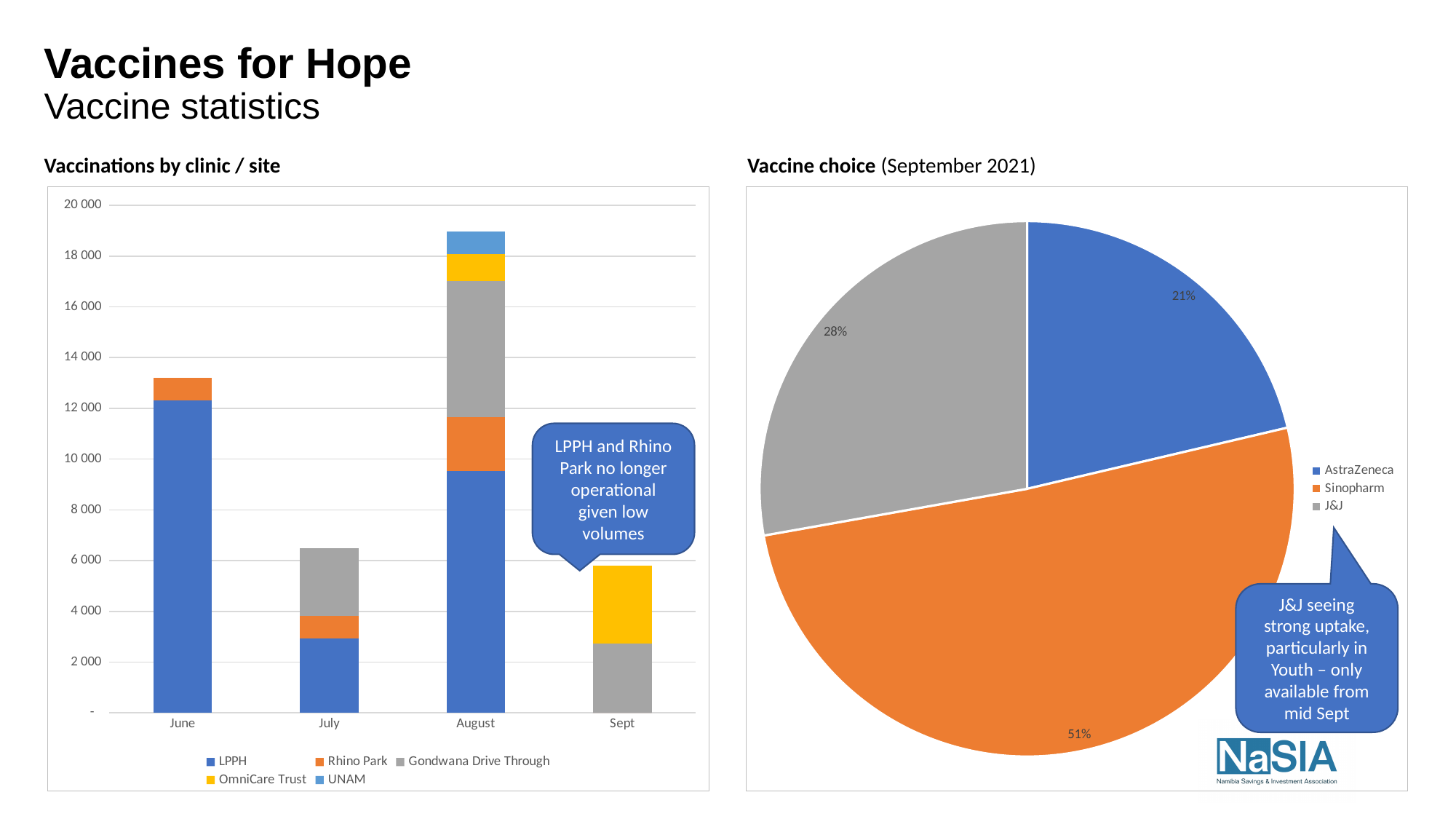
In the Vaccine choice (September 2021) pie chart, which vaccine has the smallest share? AstraZeneca In the Vaccinations by clinic / site chart, how many clinics/sites does the legend list? 5 In the Vaccinations by clinic / site chart, how many months are shown on the x axis? 4 In the Vaccine choice (September 2021) pie chart, which vaccine has the largest share? Sinopharm What type of chart is the Vaccinations by clinic / site chart? Stacked bar chart In the Vaccinations by clinic / site chart, is the total for June greater or less than 12 000? greater In the Vaccine choice (September 2021) pie chart, what share is Sinopharm? 51% In the Vaccine choice (September 2021) pie chart, how many percentage points larger is Sinopharm's share than AstraZeneca's? 30 percentage points In the Vaccine choice (September 2021) pie chart, which is larger, J&J or AstraZeneca? J&J In the Vaccinations by clinic / site chart, is the total for July greater or less than 8 000? less In the Vaccinations by clinic / site chart, which month has the highest total vaccinations? August In the Vaccine choice (September 2021) pie chart, what share is J&J? 28%